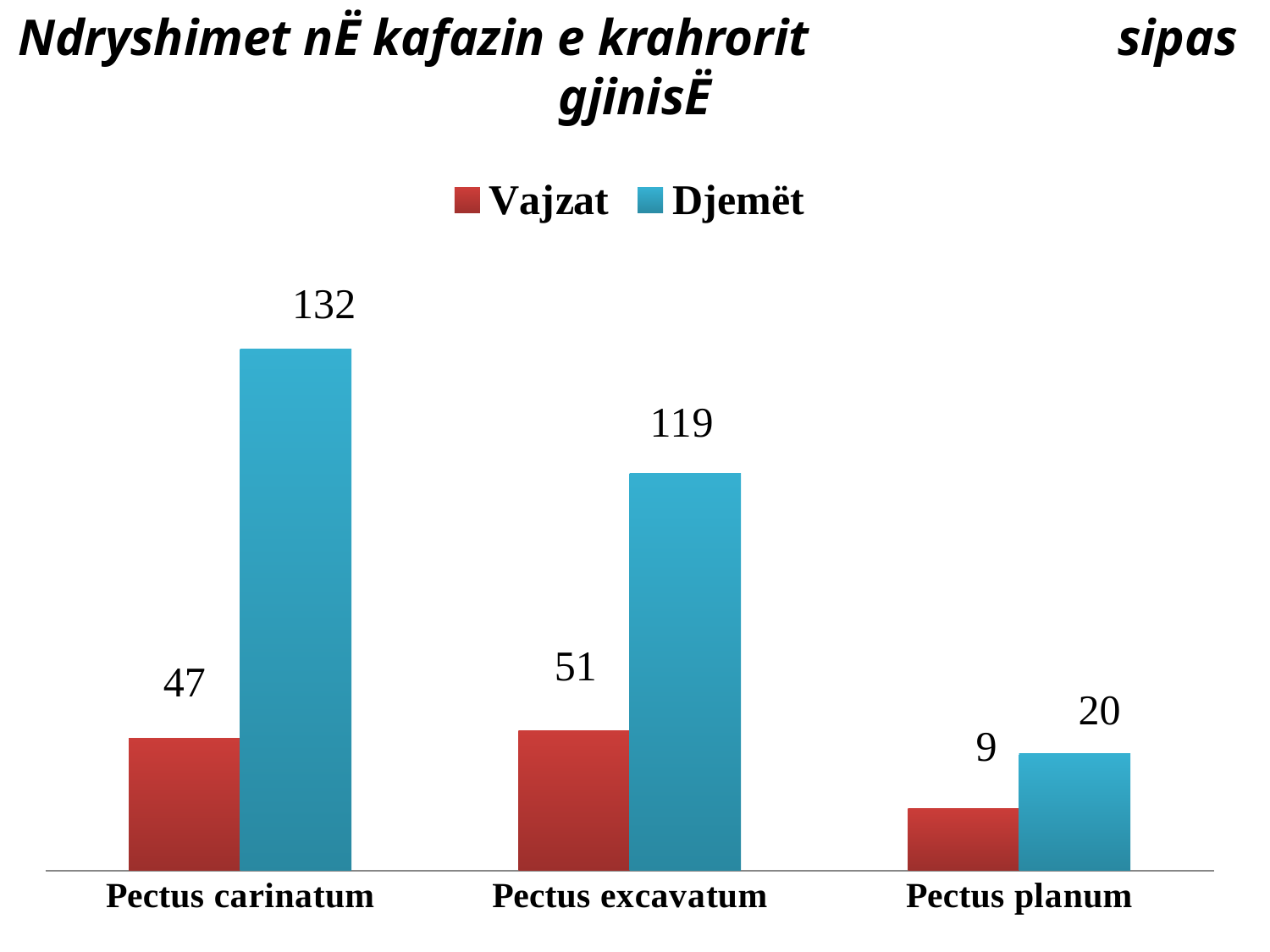
Which is larger: the Vajzat value for Pectus carinatum or the Vajzat value for Pectus excavatum? Pectus excavatum What is the value for Vajzat in the Pectus planum category? 9 What is the difference between the Djemët values for Pectus carinatum and Pectus excavatum? 13 How many categories are shown on the x axis? 3 What is the value for Djemët in the Pectus carinatum category? 132 What is the value for Vajzat in the Pectus excavatum category? 51 What is the value for Djemët in the Pectus planum category? 20 What is the difference between the Djemët and Vajzat values for Pectus carinatum? 85 Which category has the lowest value for Vajzat? Pectus planum What kind of chart is shown on the slide? Bar chart Which category has the highest value for Djemët? Pectus carinatum How many series does the legend list? 2